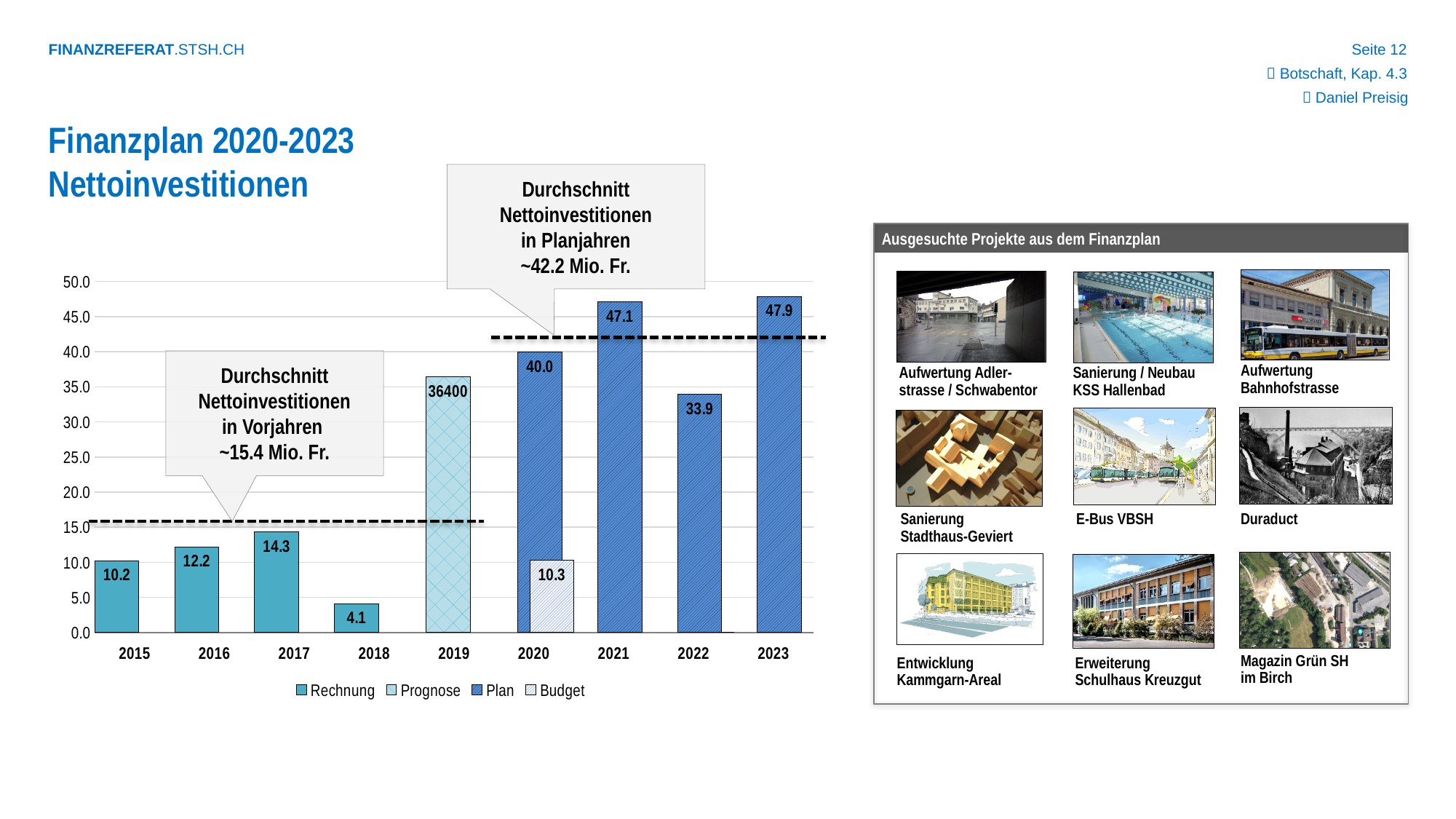
Which year has the highest Plan value? 2023 What is the Budget value for 2020? 10.3 Which year has the lowest value in the chart? 2018 What type of chart is shown on the slide? bar chart How many years are shown on the x axis of the chart? 9 What is the value for 2015 in the chart? 10.2 Which is larger, the value for 2016 or the value for 2017? 2017 What is the Plan value for 2021? 47.1 According to the callout, what is the average net investment in the plan years? ~42.2 Mio. Fr. What is the value for 2018 in the chart? 4.1 How many series does the chart legend list? 4 What is the difference between the Plan value for 2023 and the Plan value for 2022? 14.0